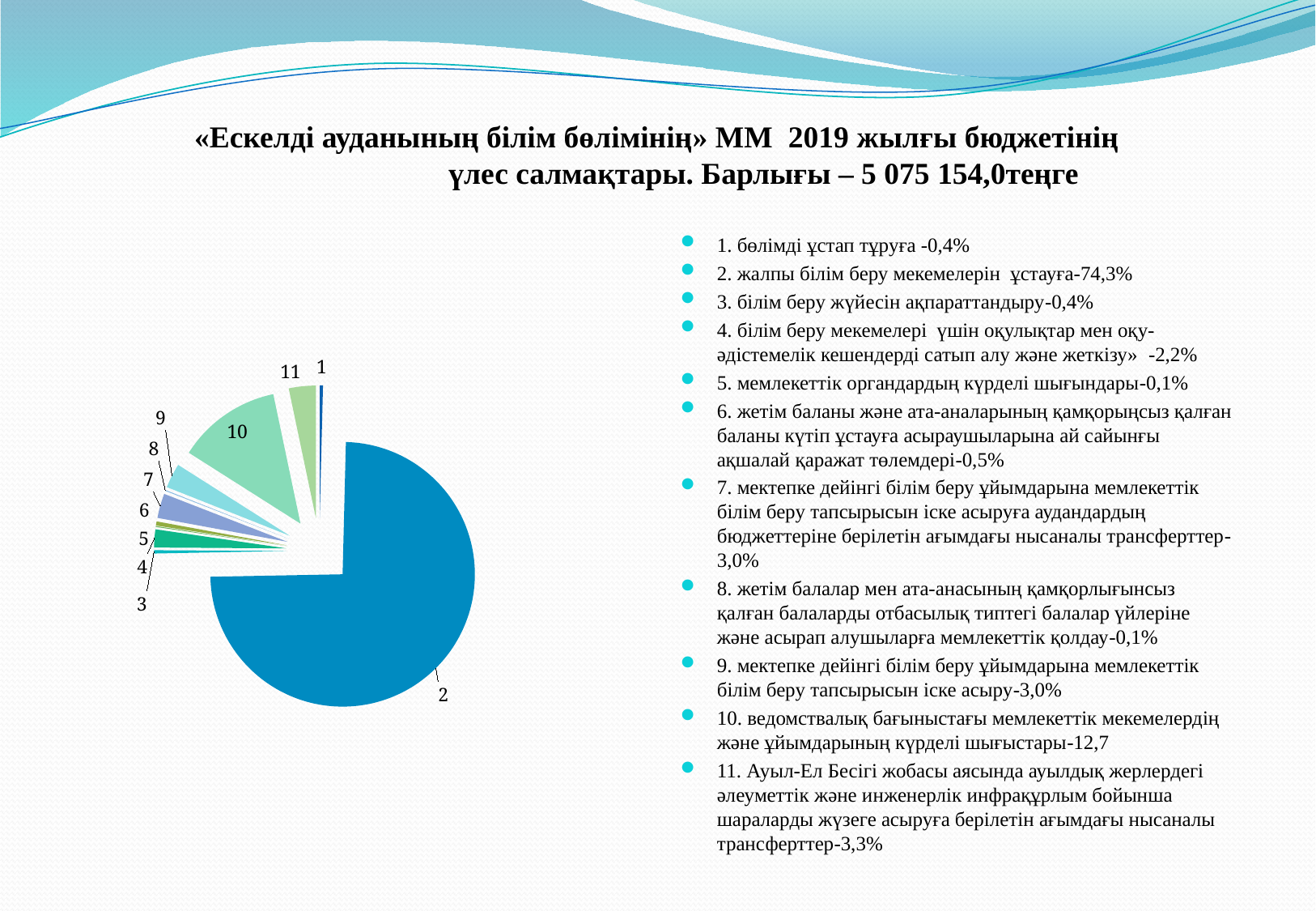
By how many percentage points does the share of slice 2 (74,3%) exceed the share of slice 10 (12,7)? 61,6 How many slices does the pie chart have? 11 According to the slide, what share of the budget does slice 2 (жалпы білім беру мекемелерін ұстауға) represent? 74,3% According to the slide, what share of the budget does slice 11 (Ауыл-Ел Бесігі жобасы) represent? 3,3% Which slice of the pie chart is the largest? 2 What total budget amount is stated in the slide title? 5 075 154,0 теңге What kind of chart is shown on the slide? pie chart Which is larger in the pie chart, slice 2 or slice 10? slice 2 Which is larger in the pie chart, slice 9 or slice 1? slice 9 Which is larger in the pie chart, slice 10 or slice 11? slice 10 According to the slide, what share of the budget does slice 10 (ведомствалық бағыныстағы мемлекеттік мекемелердің және ұйымдарының күрделі шығыстары) represent? 12,7 According to the slide, what share of the budget does slice 1 (бөлімді ұстап тұруға) represent? 0,4%